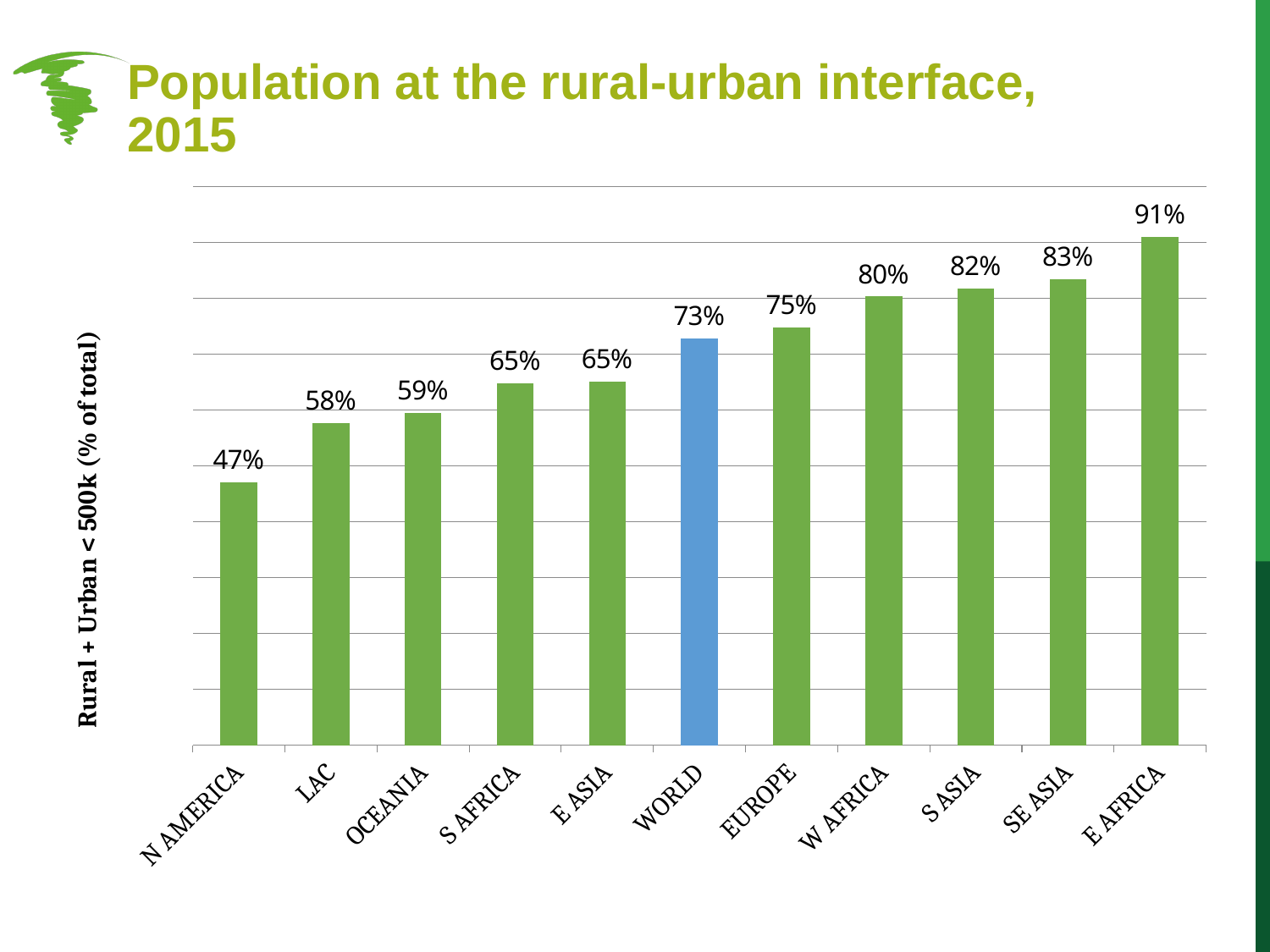
What is the value for N AMERICA? 47% What is the value for W AFRICA? 80% Which category has the highest value? E AFRICA What kind of chart is shown on the slide? Bar chart What is the difference between the values for SE ASIA and WORLD? 10% Which category has the lowest value? N AMERICA What is the value for WORLD? 73% Which bar is coloured blue rather than green? WORLD What is the difference between the values for E AFRICA and N AMERICA? 44% How many categories are shown on the x axis? 11 Do the values rise or fall from left to right along the x axis? Rise Which is larger, the value for EUROPE or the value for OCEANIA? EUROPE